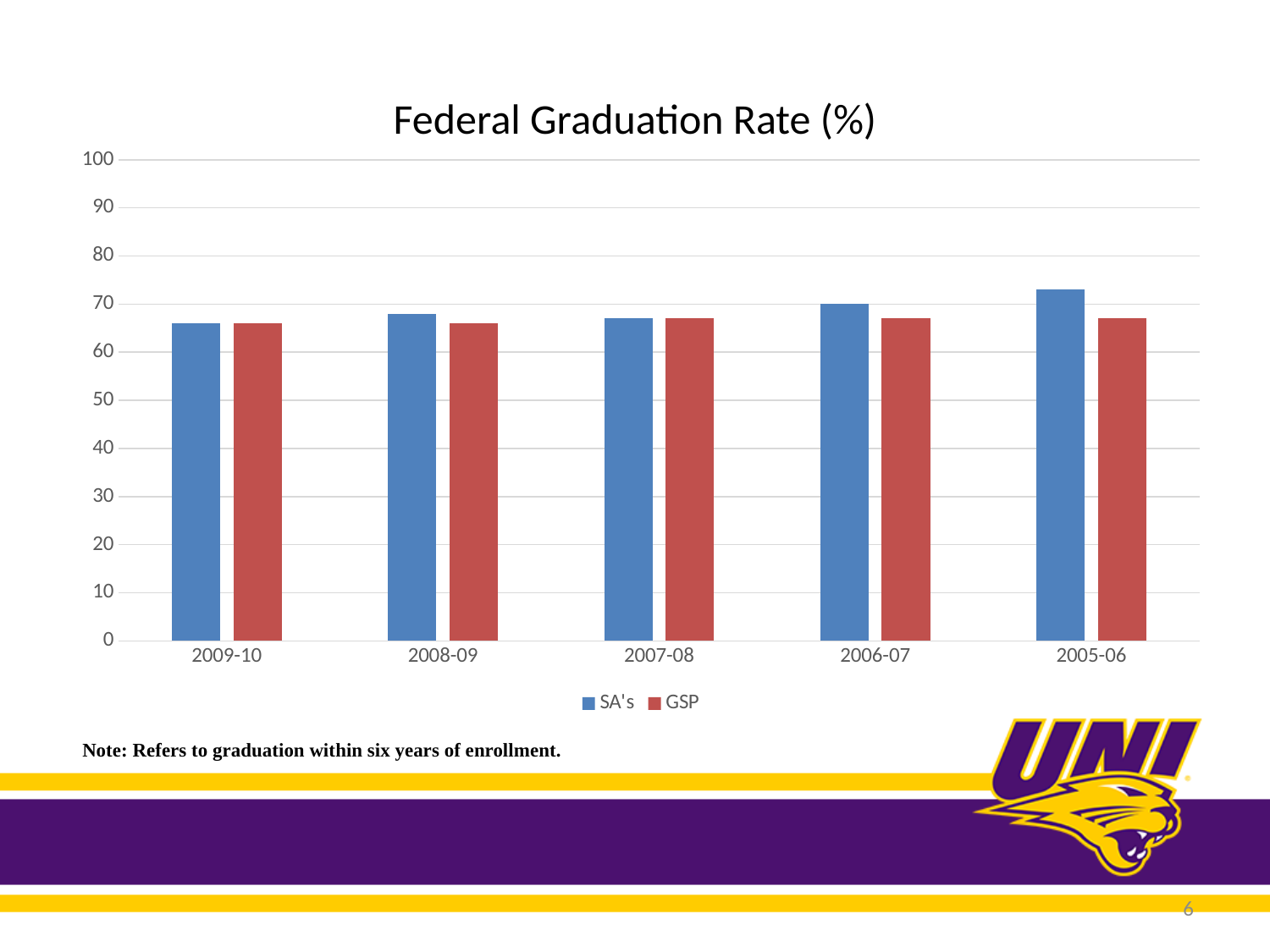
How many series does the legend list? 2 For 2006-07, which series has the larger value, SA's or GSP? SA's Is the GSP value for 2009-10 greater or less than 70? less How many academic years are shown on the x axis? 5 Is the SA's value for 2005-06 greater or less than 70? greater Is the GSP value for 2005-06 greater or less than 70? less For 2005-06, which series has the larger value, SA's or GSP? SA's What is the title of the chart? Federal Graduation Rate (%) Which series is shown in red in the legend? GSP In which year is the SA's value highest? 2005-06 What kind of chart is shown on the slide? bar chart